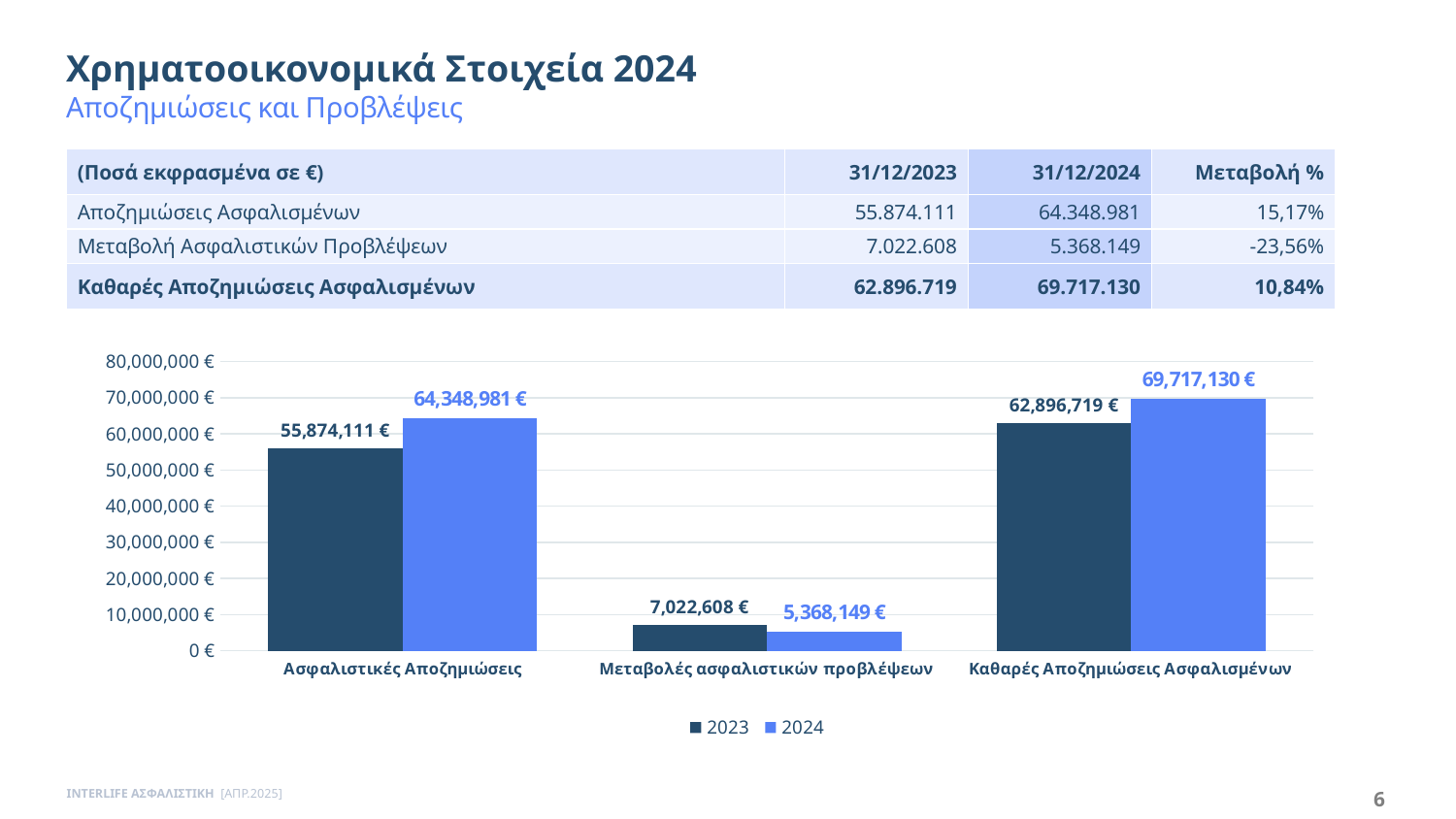
How many categories are shown on the x axis of the chart? 3 What is the 2024 value for Ασφαλιστικές Αποζημιώσεις in the chart? 64,348,981 € Which category has the highest 2023 value in the chart? Καθαρές Αποζημιώσεις Ασφαλισμένων What is the 2024 value for Καθαρές Αποζημιώσεις Ασφαλισμένων in the chart? 69,717,130 € What kind of chart is shown on the slide? Bar chart Which category has the lowest 2024 value in the chart? Μεταβολές ασφαλιστικών προβλέψεων In the chart, is the 2023 or the 2024 value larger for Μεταβολές ασφαλιστικών προβλέψεων? 2023 What is the 2023 value for Μεταβολές ασφαλιστικών προβλέψεων in the chart? 7,022,608 € How many series does the chart legend list? 2 What is the difference between the 2024 and 2023 values for Ασφαλιστικές Αποζημιώσεις in the chart? 8,474,870 € What is the difference between the 2023 and 2024 values for Μεταβολές ασφαλιστικών προβλέψεων in the chart? 1,654,459 € Is the 2023 value for Καθαρές Αποζημιώσεις Ασφαλισμένων greater or less than 60,000,000 €? greater